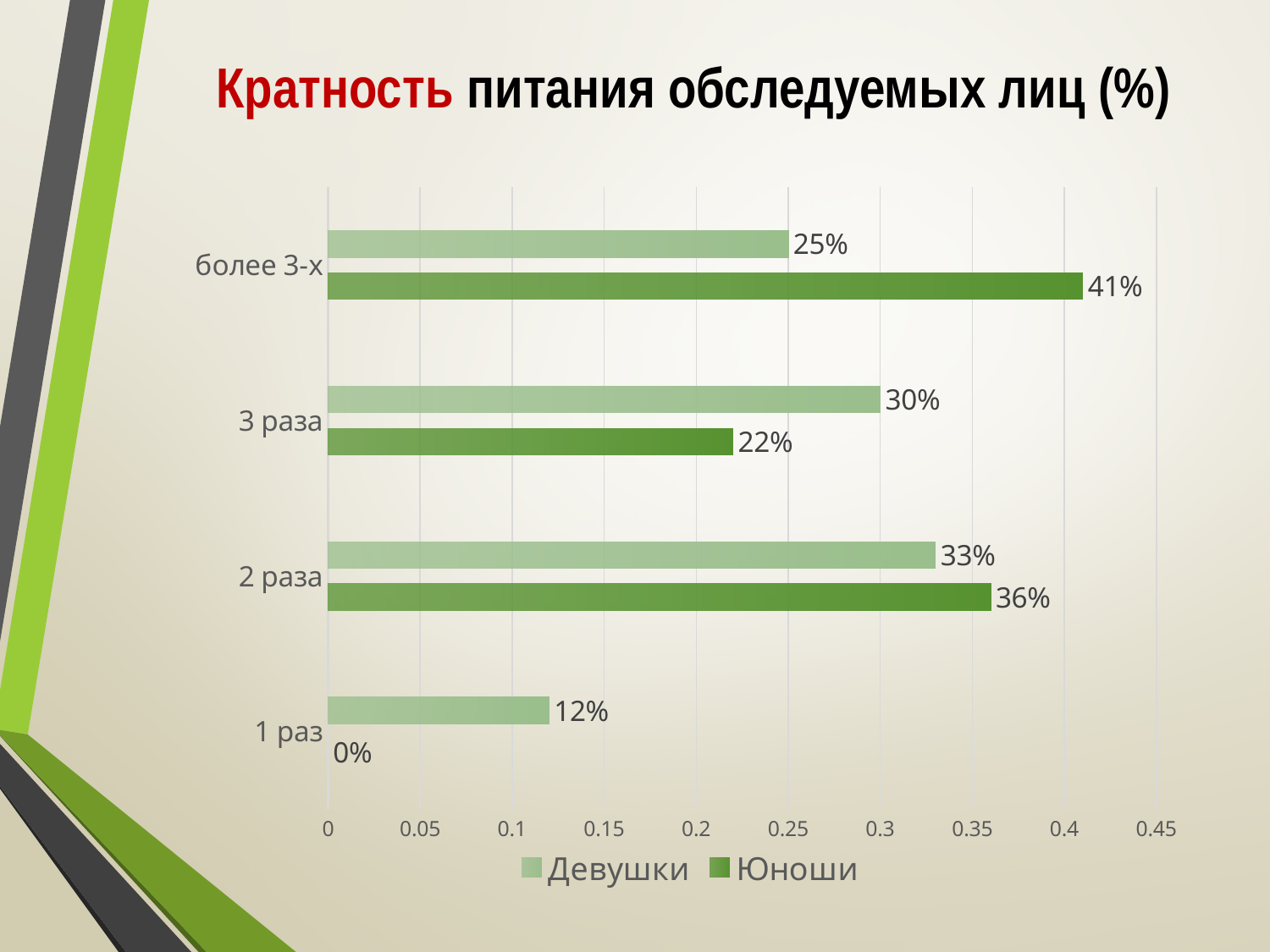
Which series is shown in the darker green colour? Юноши Which category has the lowest value for Девушки? 1 раз What is the difference between Юноши and Девушки in the 'более 3-х' category? 16% How many series does the legend list? 2 What is the value for Девушки in the 'более 3-х' category? 25% What kind of chart is shown on the slide? Bar chart What is the value for Юноши in the '1 раз' category? 0% Is the value for Девушки in the '2 раза' category greater or less than 0.3? greater In the '2 раза' category, which series has the larger value, Девушки or Юноши? Юноши How many categories are shown on the chart? 4 What is the value for Юноши in the '3 раза' category? 22% Which category has the highest value for Юноши? более 3-х